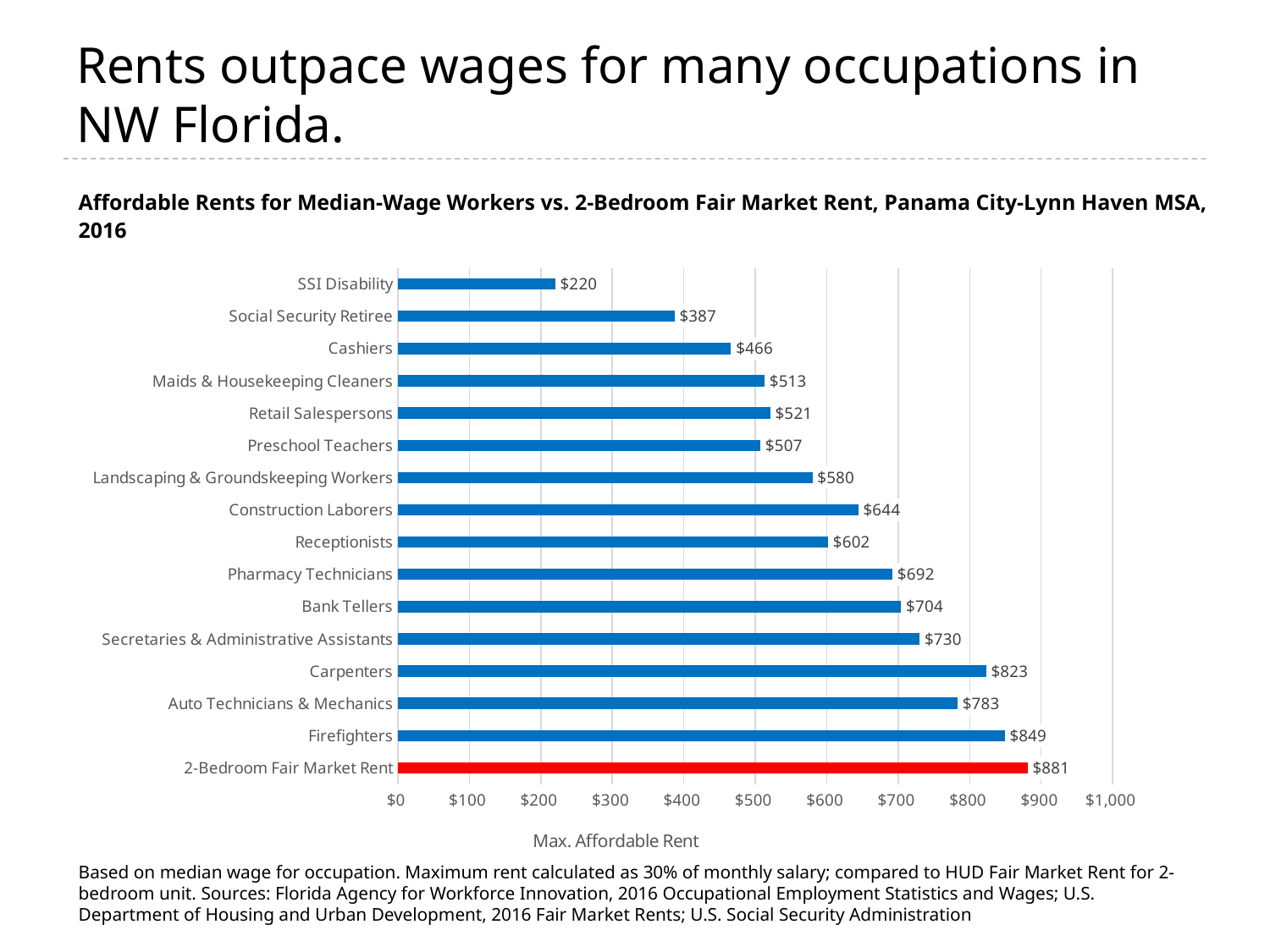
How many categories are plotted on the chart? 16 What is the maximum affordable rent for Firefighters? $849 Which is larger: the value for Carpenters or the value for Auto Technicians & Mechanics? Carpenters What kind of chart is shown on the slide? Bar chart Which category has the lowest value on the chart? SSI Disability Which bar is coloured red instead of blue? 2-Bedroom Fair Market Rent Is the value for Construction Laborers greater or less than $600? greater What is the difference between the values for Bank Tellers and Pharmacy Technicians? $12 What is the maximum affordable rent for Cashiers? $466 What is the value shown for 2-Bedroom Fair Market Rent? $881 Which category has the highest value on the chart? 2-Bedroom Fair Market Rent What is the difference between the 2-Bedroom Fair Market Rent and the maximum affordable rent for Firefighters? $32